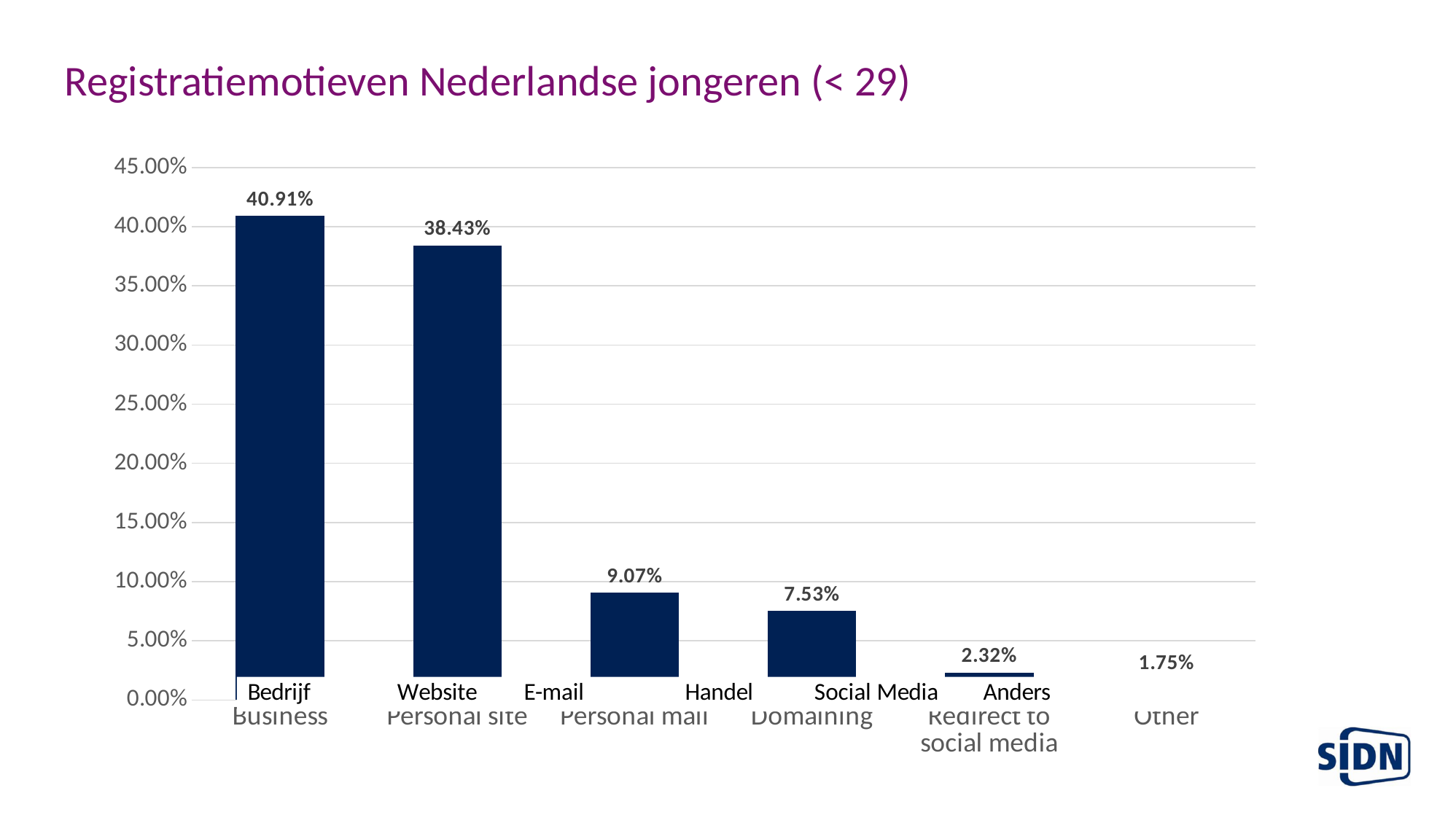
Which category has the lowest value? Other (Anders) Which is larger, the value for Personal mail or the value for Domaining? Personal mail What kind of chart is shown on the slide? Bar chart What is the value for Personal mail (E-mail)? 9.07% What is the value for Business (Bedrijf)? 40.91% What is the value for Domaining (Handel)? 7.53% How many categories are shown in the chart? 6 Which category has the highest value? Business (Bedrijf) What is the value for Other (Anders)? 1.75% What is the value for Personal site (Website)? 38.43% What is the title of the slide? Registratiemotieven Nederlandse jongeren (< 29) What is the difference between the values for Business and Personal site? 2.48%